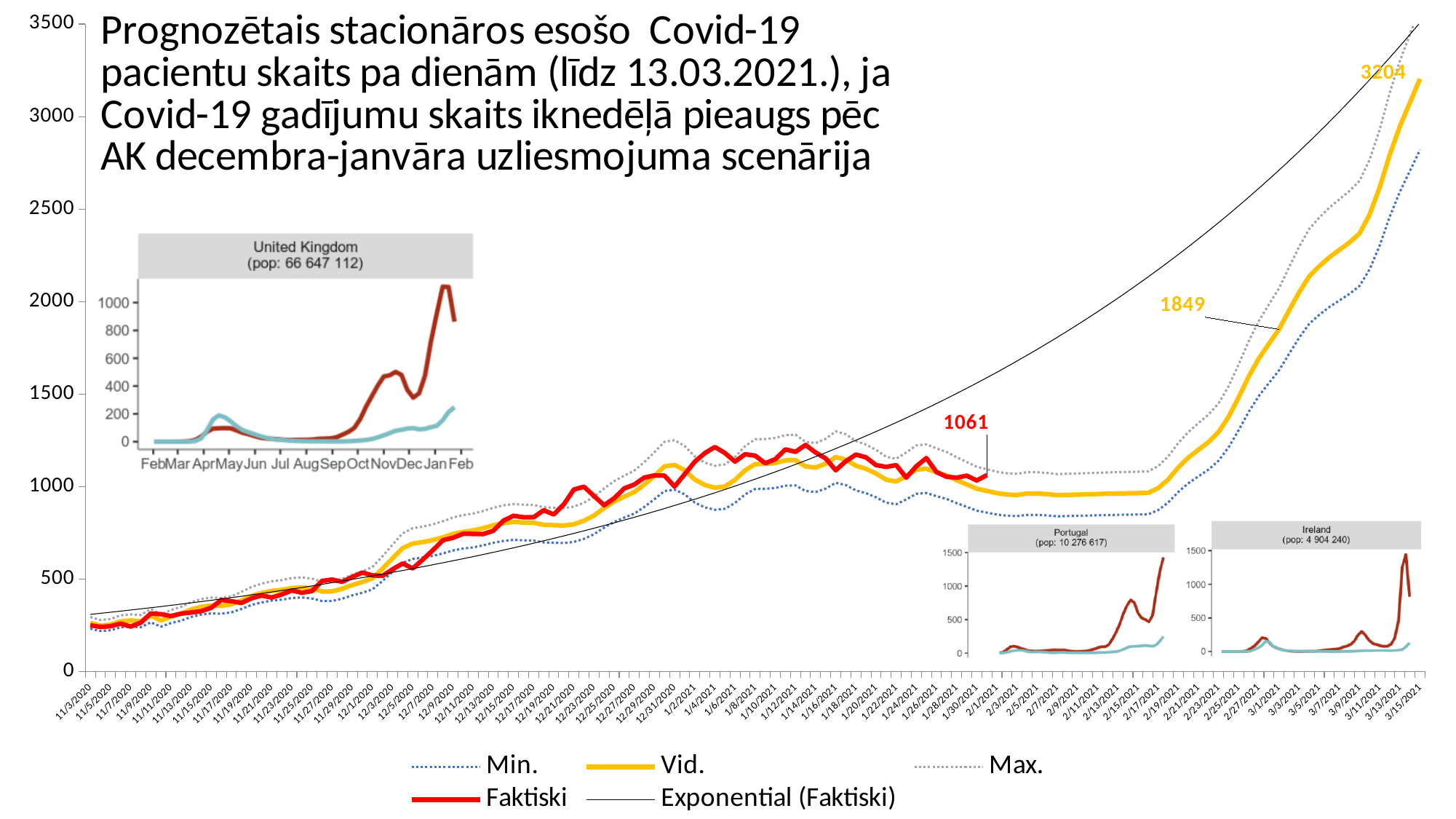
In the main chart, is the value of the Faktiski series at 11/3/2020 greater or less than 500? less In the main chart, is the value of the Min. series at 2/5/2021 greater or less than 1000? less In the main chart, what is the labelled value at the end of the Vid. series? 3204 What kind of chart is the main chart on the slide? line chart In the main chart, does the Vid. series rise or fall between 2/17/2021 and 3/15/2021? rise How many series does the legend of the main chart list? 5 In the main chart, what is the labelled value on the Vid. series around 2/27/2021? 1849 In the main chart, is the value of the Min. series at 3/15/2021 greater or less than 2500? greater In the main chart, which labelled value is larger: the Vid. value 3204 or the Faktiski value 1061? Vid. (3204) In the main chart, which series is lowest at 3/15/2021, Min. or Vid.? Min. In the main chart, what is the difference between the two labelled Vid. values, 3204 and 1849? 1355 In the main chart, what is the labelled value at the end of the Faktiski series? 1061